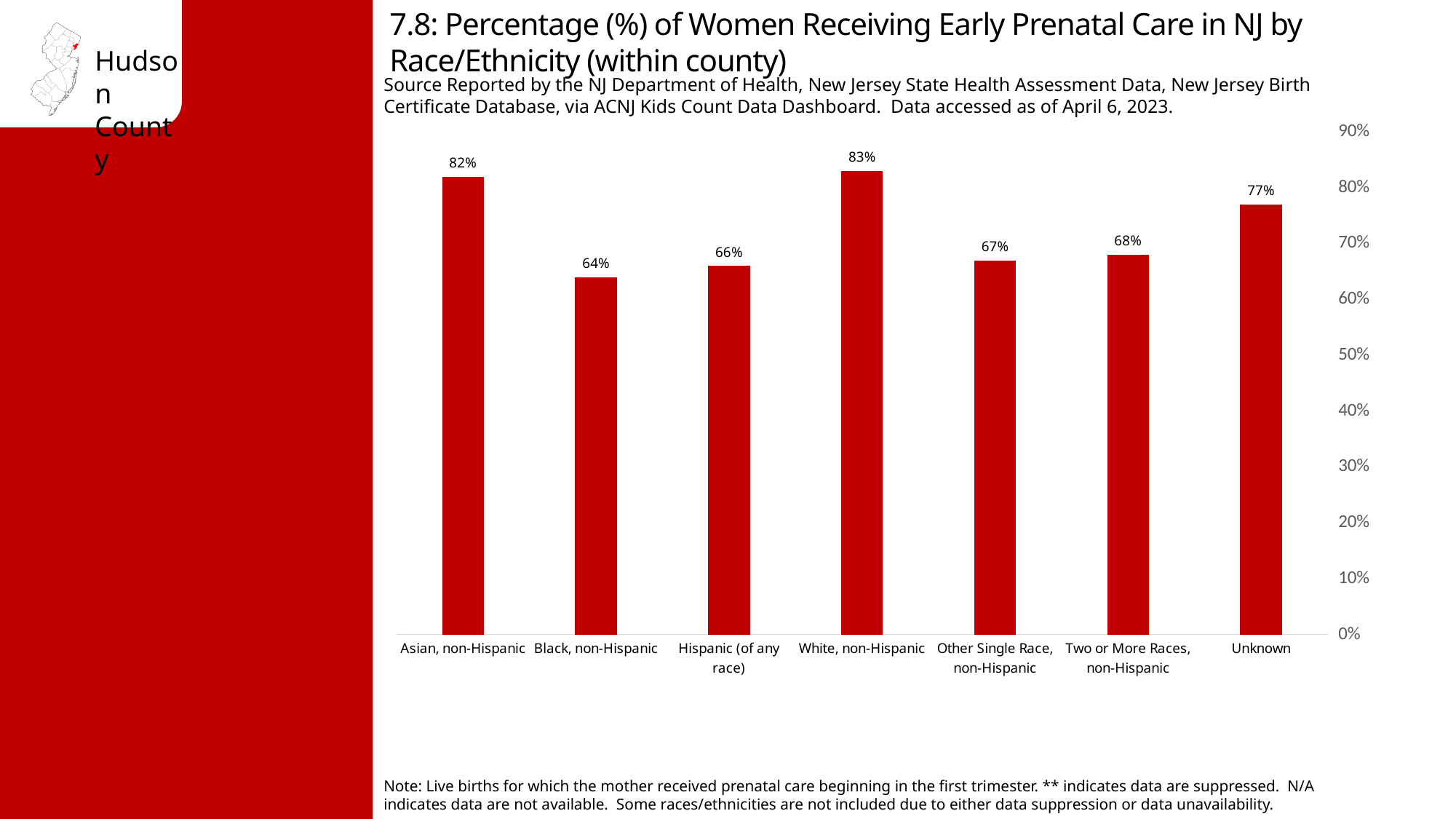
Which race/ethnicity category has the lowest percentage? Black, non-Hispanic How many race/ethnicity categories are shown on the chart? 7 Which race/ethnicity category has the highest percentage of women receiving early prenatal care? White, non-Hispanic What kind of chart is shown on the slide? Bar chart Which is larger: the value for Two or More Races, non-Hispanic or the value for Other Single Race, non-Hispanic? Two or More Races, non-Hispanic What is the value shown for Black, non-Hispanic? 64% What percentage of Asian, non-Hispanic women received early prenatal care? 82% What is the value for the Unknown category? 77% What percentage is shown for Hispanic (of any race)? 66% What is the difference between the White, non-Hispanic value and the Black, non-Hispanic value? 19 percentage points Is the value for Unknown greater or less than 70%? greater What is the highest value shown on the vertical axis? 90%